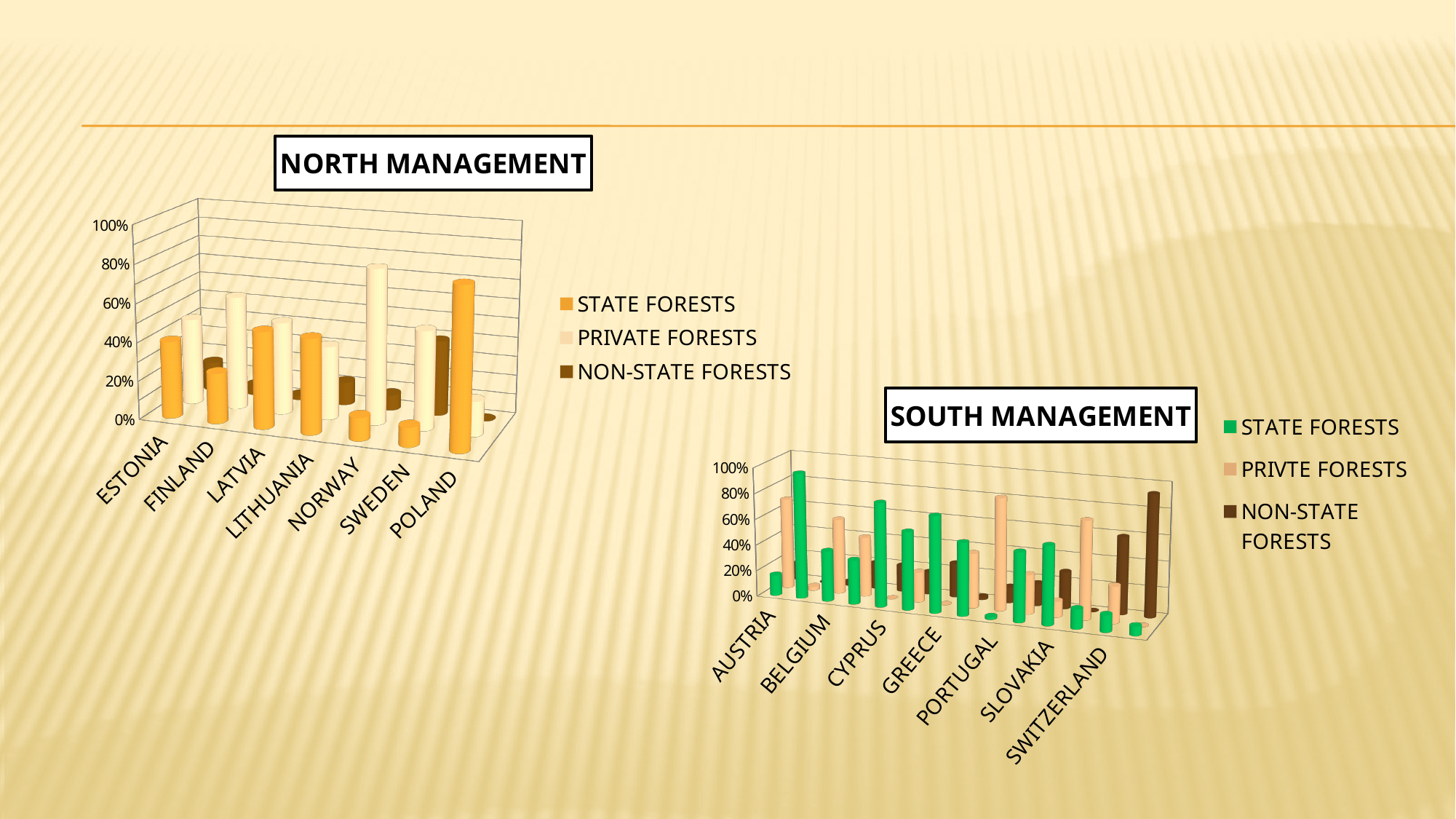
In the North Management chart, which country has the highest State Forests value? Poland What is the second legend entry of the South Management chart, as written on the slide? PRIVTE FORESTS How many countries are shown on the x axis of the North Management chart? 7 In the North Management chart, which is larger for Norway: State Forests or Private Forests? Private Forests How many series does the legend of the North Management chart list? 3 What type of chart is the North Management chart? bar chart In the North Management chart, is the State Forests value for Poland greater or less than 60%? greater How many countries are shown on the x axis of the South Management chart? 7 In the South Management chart, which country has the highest Non-State Forests value? Switzerland In the North Management chart, which country has the highest Private Forests value? Norway